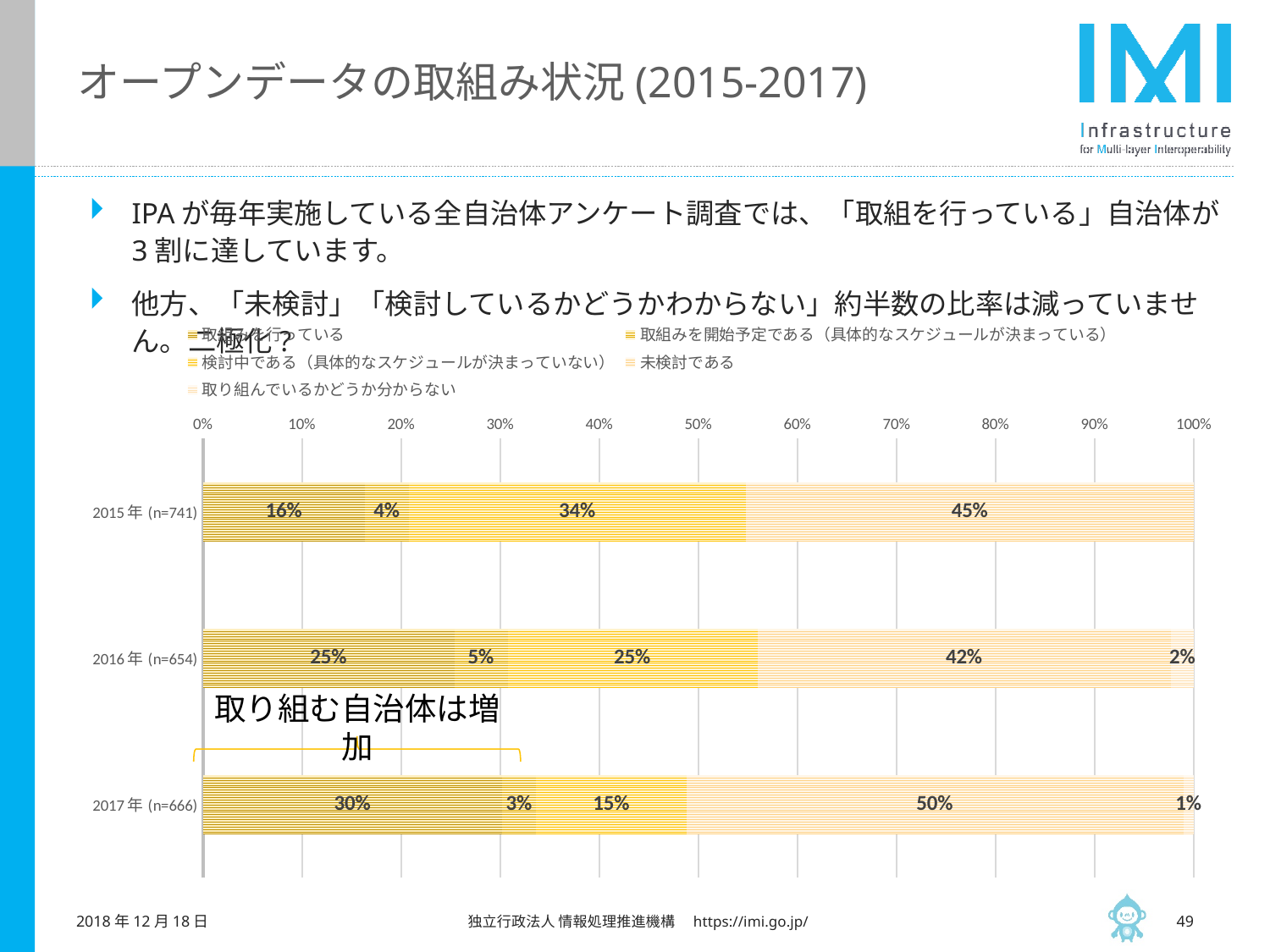
Which year has the larger value for 検討中である（具体的なスケジュールが決まっていない）, 2016年 or 2017年? 2016年 (n=654) What is the value for 取り組んでいるかどうか分からない in 2017年 (n=666)? 1% What kind of chart is shown on the slide? Stacked bar chart How many survey years (categories) are plotted in the chart? 3 Which year has the lowest value for 未検討である? 2016年 (n=654) What is the value for 取組みを開始予定である（具体的なスケジュールが決まっている） in 2016年 (n=654)? 5% What is the value for 検討中である（具体的なスケジュールが決まっていない） in 2015年 (n=741)? 34% What is the value for 未検討である in 2017年 (n=666)? 50% Which year has the highest value for 未検討である? 2017年 (n=666) By how many percentage points did the first (leftmost) segment increase from 2015年 (16%) to 2017年 (30%)? 14% How many series does the chart legend list? 5 Does the value for 検討中である（具体的なスケジュールが決まっていない） rise or fall from 2015年 to 2017年? Fall